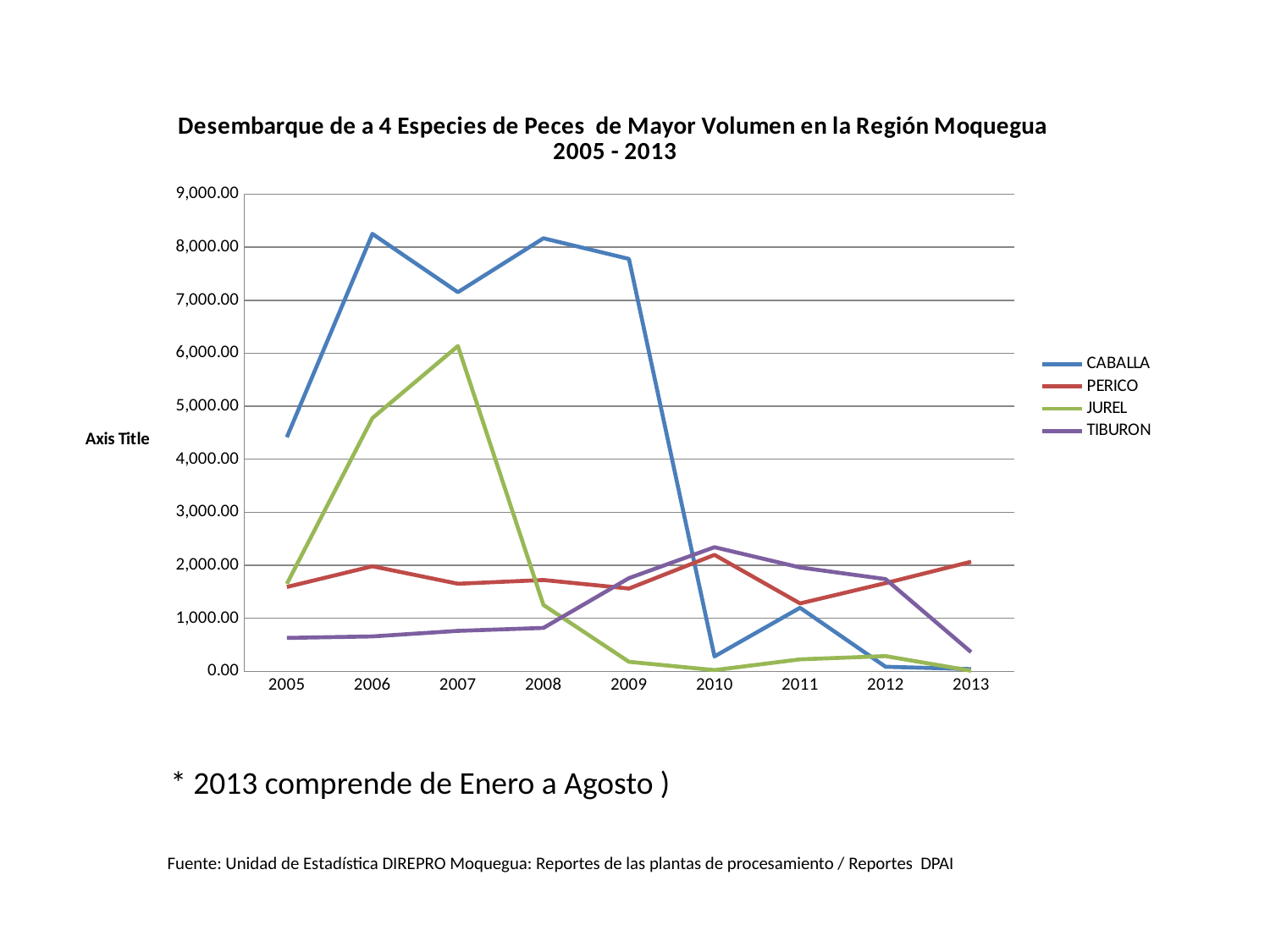
Is the value for TIBURON in 2005 greater or less than 1,000.00? less Is the value for CABALLA in 2006 greater or less than 8,000.00? greater In 2009, which is larger: the value for CABALLA or the value for JUREL? CABALLA Is the value for JUREL in 2007 greater or less than 5,000.00? greater Which series has the lowest value in 2005? TIBURON What kind of chart is shown on the slide? line chart How many series does the legend list? 4 Which series has the highest value in 2013? PERICO In which year does JUREL reach its highest value? 2007 Does the CABALLA line rise or fall from 2009 to 2010? fall How many years are shown on the x axis? 9